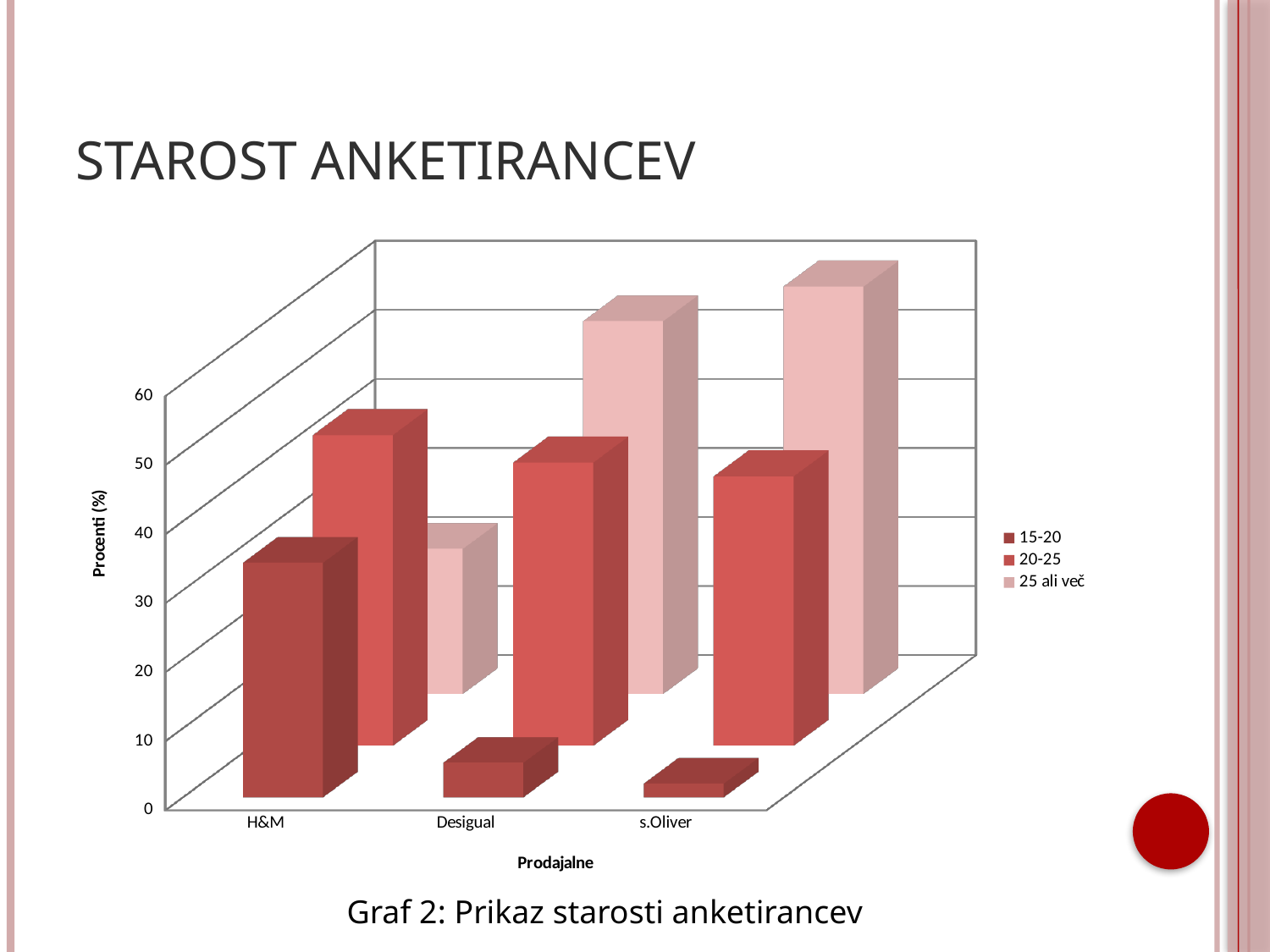
Which store has the highest value for the 15-20 age group? H&M Is the value for the 15-20 age group at Desigual greater or less than 20? less How many series does the legend list? 3 Which is larger: the 25 ali več value for Desigual or for H&M? Desigual For H&M, which age group has the highest value? 20-25 Is the value for the 15-20 age group at H&M greater or less than 20? greater What is the title of the vertical axis? Procenti (%) Is the value for the 15-20 age group at s.Oliver greater or less than 10? less What kind of chart is shown on the slide? bar chart What are the three age groups listed in the legend? 15-20, 20-25, 25 ali več How many stores (categories) are shown on the x axis? 3 Which store has the lowest value for the 15-20 age group? s.Oliver